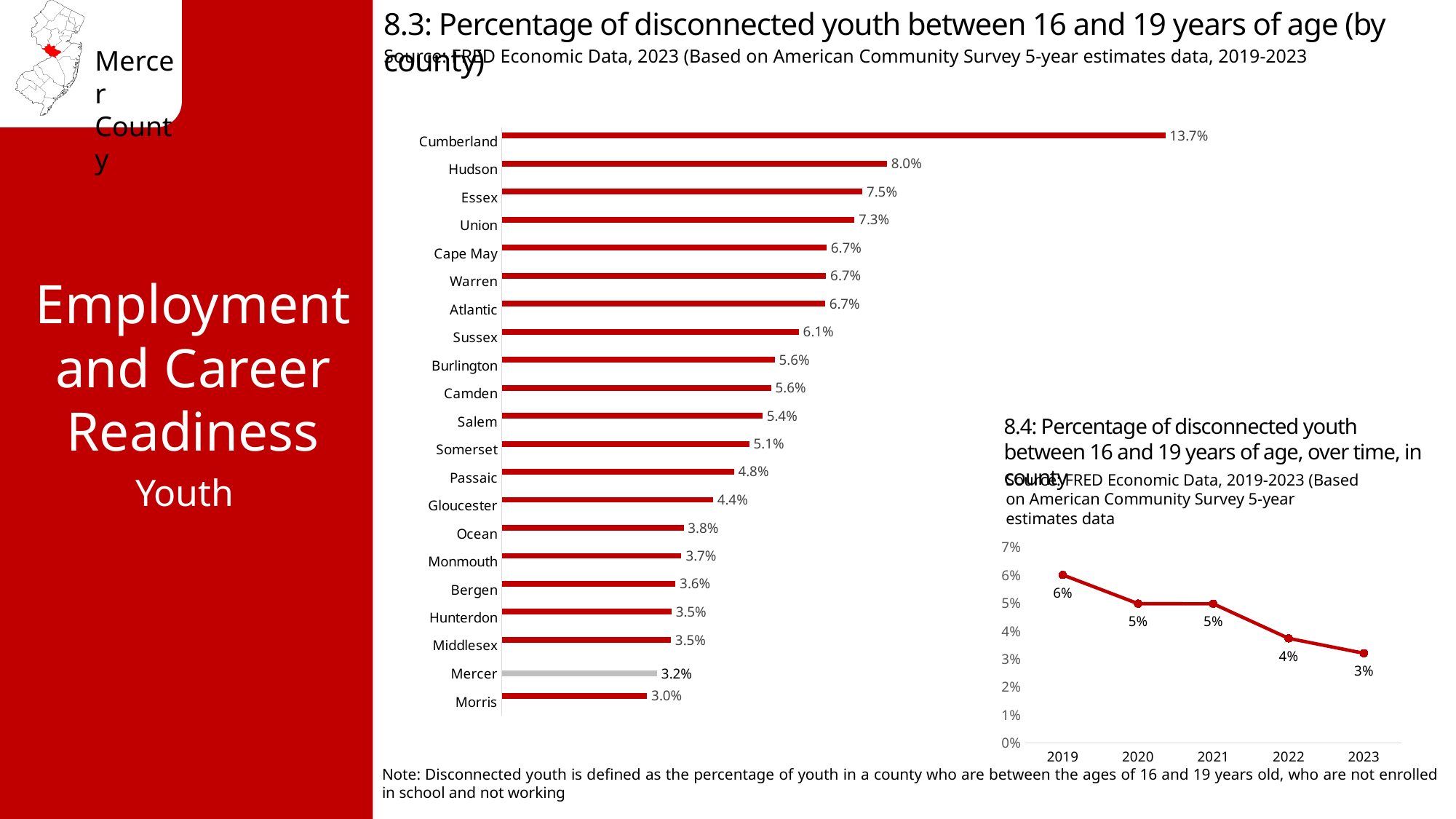
In chart 8.3 (percentage of disconnected youth by county), which is larger, the value for Essex or the value for Union? Essex In chart 8.4 (percentage of disconnected youth over time), what is the value for 2019? 6% In chart 8.3 (percentage of disconnected youth by county), what is the value for Mercer? 3.2% In chart 8.3 (percentage of disconnected youth by county), which county has the highest value? Cumberland In chart 8.3 (percentage of disconnected youth by county), what is the value for Hudson? 8.0% In chart 8.3 (percentage of disconnected youth by county), how many counties are shown? 21 What kind of chart is chart 8.4 (percentage of disconnected youth over time)? Line chart In chart 8.4 (percentage of disconnected youth over time), what is the value for 2023? 3% In chart 8.4 (percentage of disconnected youth over time), do the values rise or fall from 2019 to 2023? Fall What kind of chart is chart 8.3 (percentage of disconnected youth by county)? Bar chart In chart 8.3 (percentage of disconnected youth by county), what is the difference between Cumberland and Mercer? 10.5% In chart 8.3 (percentage of disconnected youth by county), which county has the lowest value? Morris